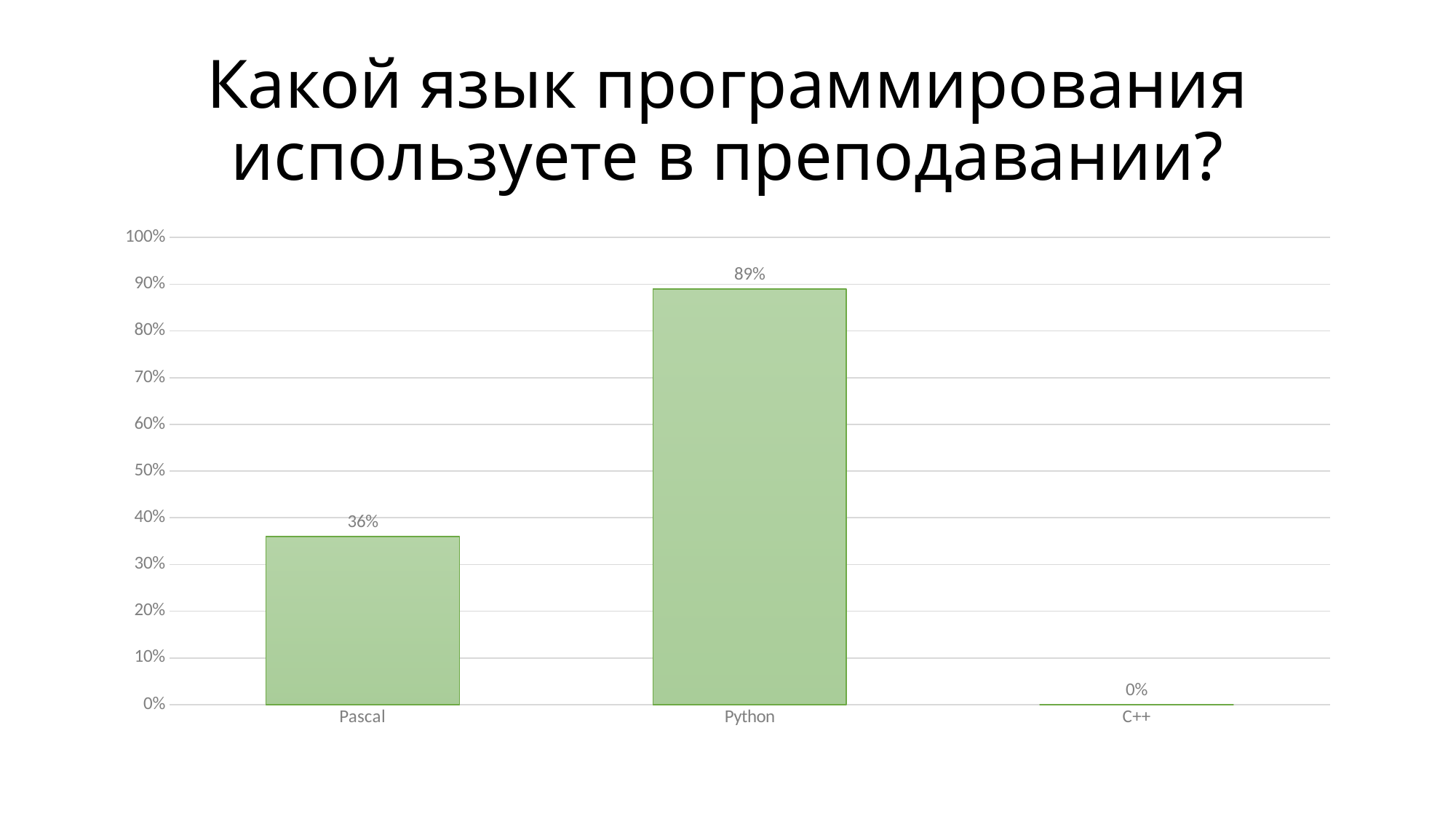
What is the title of the slide? Какой язык программирования используете в преподавании? Which is larger, the value for Pascal or the value for Python? Python How many categories are shown on the x axis? 3 What is the difference between the values for Python and Pascal? 53% Which category has the lowest value? C++ Which category has the highest value? Python What is the value for Python? 89% Is the value for Pascal greater or less than 50%? less Is the value for Python greater or less than 80%? greater What is the value for Pascal? 36% What kind of chart is shown on the slide? bar chart What is the value for C++? 0%